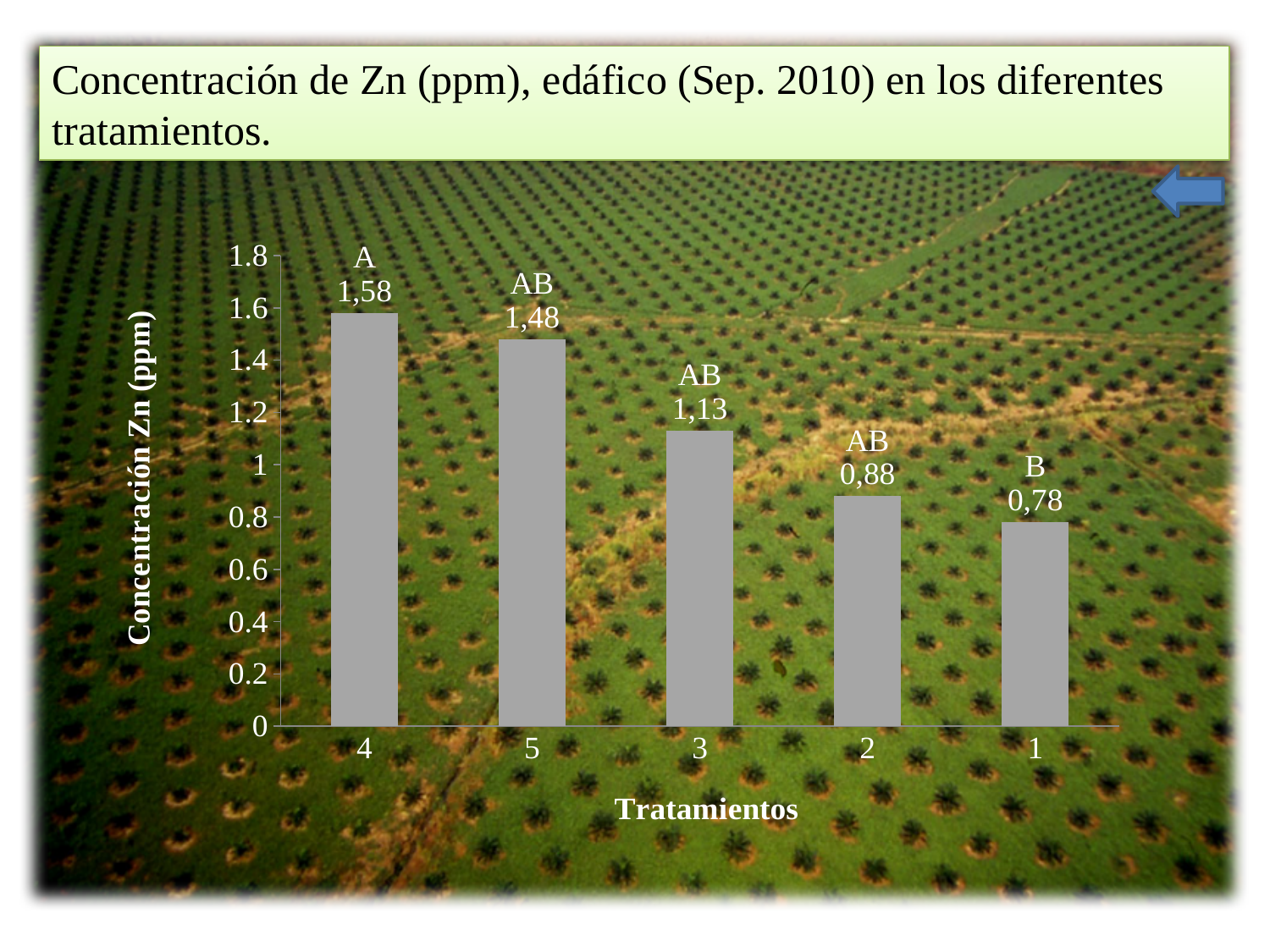
Which has a higher Zn concentration, treatment 2 or treatment 3? treatment 3 What is the Zn concentration for treatment 3? 1,13 What is the difference in Zn concentration between treatment 5 and treatment 3? 0,35 How many treatments are shown on the chart? 5 What is the difference in Zn concentration between treatment 4 and treatment 1? 0,80 Which treatment has the highest Zn concentration? 4 What is the Zn concentration for treatment 1? 0,78 What kind of chart is shown on the slide? bar chart Which treatment has the lowest Zn concentration? 1 What statistical group letter is shown above the bar for treatment 1? B What is the Zn concentration for treatment 4? 1,58 Is the value for treatment 2 greater or less than 1? less